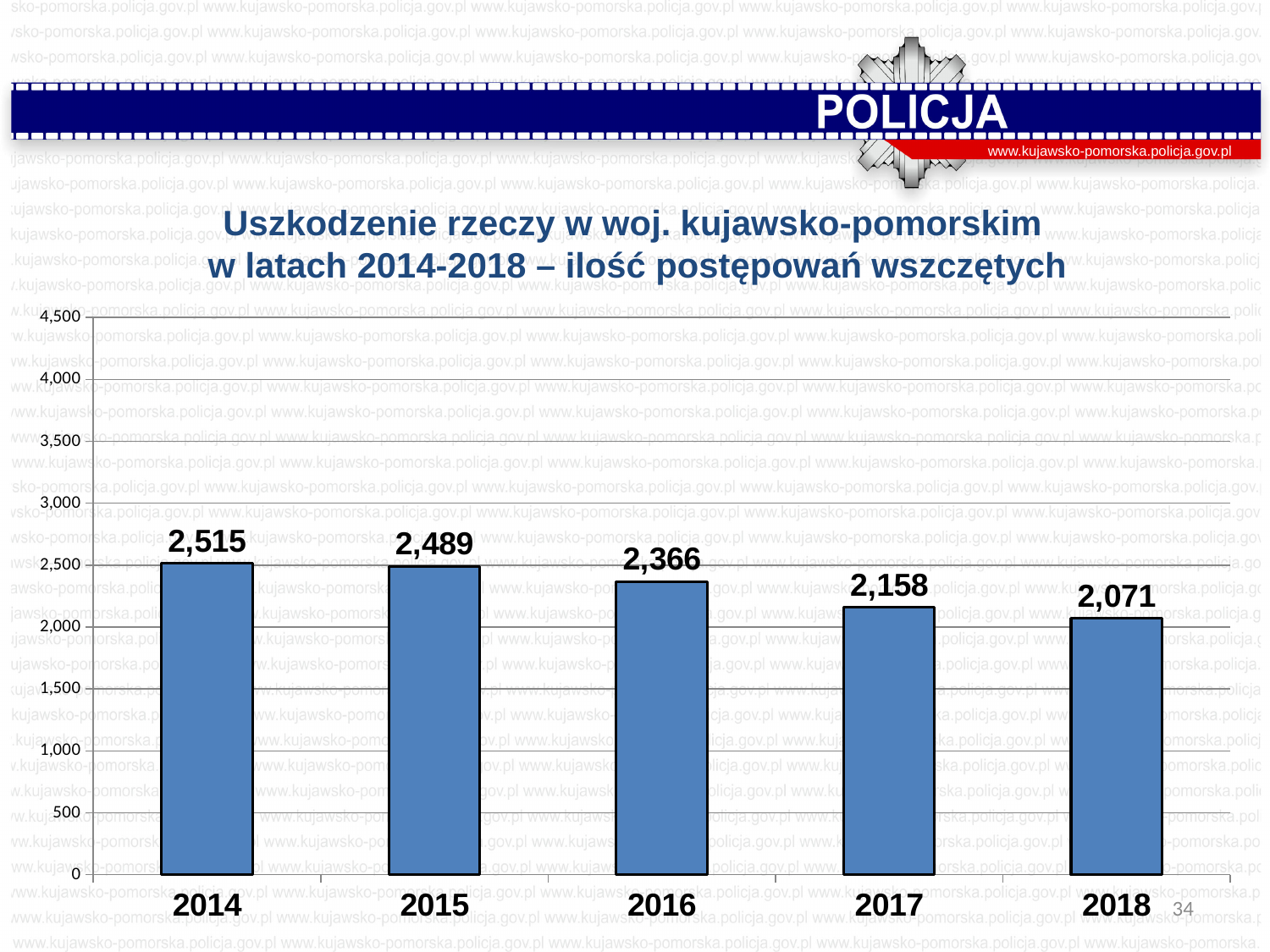
What is the difference between the values for 2016 and 2017? 208 What is the value for 2014? 2,515 What is the difference between the values for 2014 and 2018? 444 Which year has the lowest value? 2018 Which is larger, the value for 2015 or the value for 2017? 2015 Do the values rise or fall from 2014 to 2018? fall What kind of chart is shown on the slide? bar chart Which year has the highest value? 2014 What is the value for 2018? 2,071 Is the value for 2017 greater or less than 2,500? less What is the value for 2016? 2,366 How many years are shown on the chart? 5